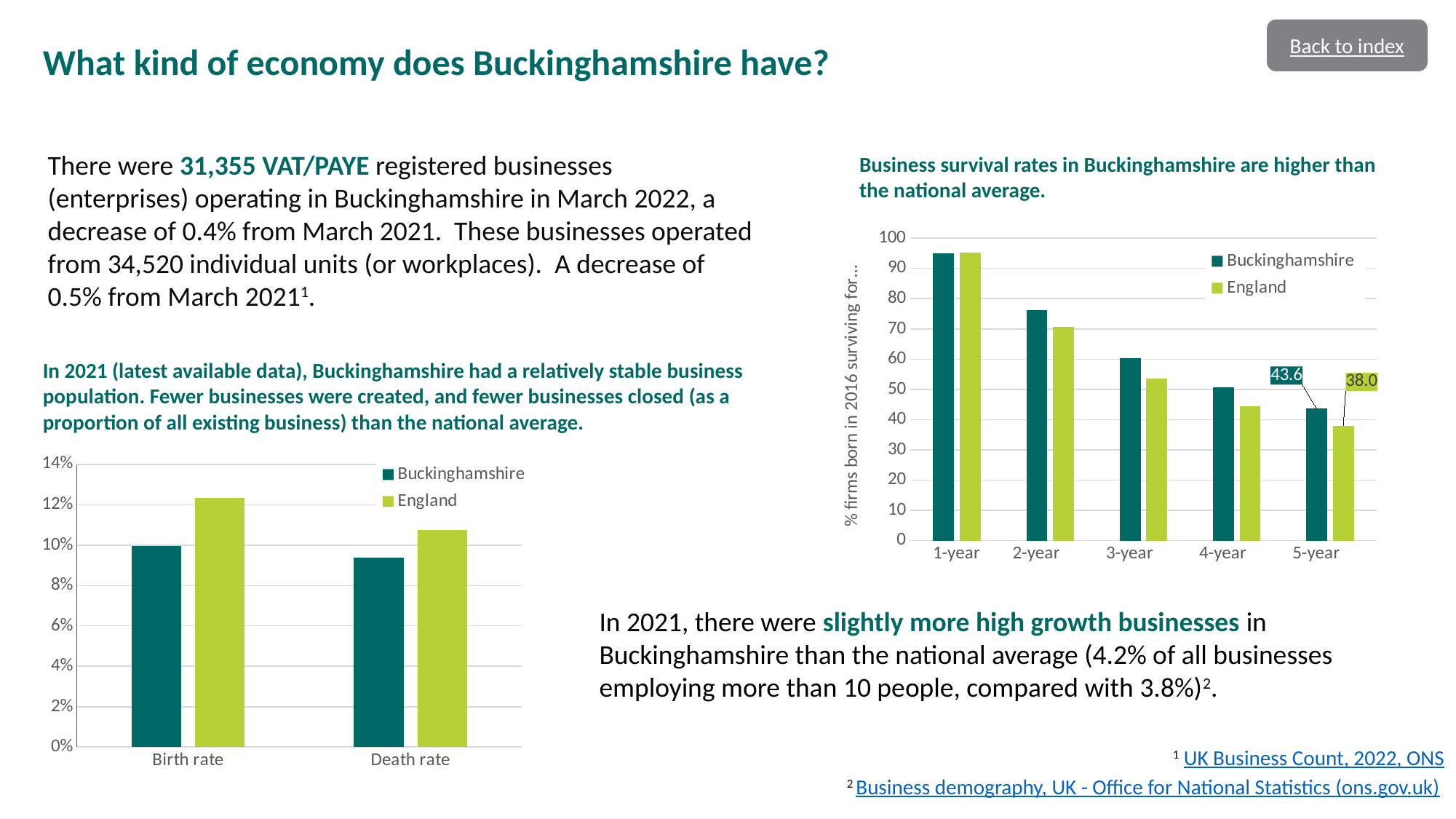
In the business survival rates chart, which series has the larger 5-year value, Buckinghamshire or England? Buckinghamshire In the business survival rates chart, how many survival periods are shown on the x axis? 5 In the business survival rates chart, what is the 5-year survival value for England? 38.0 In the birth rate and death rate chart on the left, is the England birth rate greater or less than 12%? greater In the business survival rates chart, what is the difference between the Buckinghamshire and England 5-year survival values? 5.6 In the business survival rates chart, is the 2-year value for Buckinghamshire greater or less than 70? greater What kind of chart is the birth rate and death rate chart on the left? bar chart In the business survival rates chart, is the 3-year value for England greater or less than 60? less In the business survival rates chart, what is the 5-year survival value for Buckinghamshire? 43.6 In the birth rate and death rate chart on the left, which series has the higher birth rate, Buckinghamshire or England? England In the birth rate and death rate chart on the left, how many series does the legend list? 2 In the business survival rates chart, do the Buckinghamshire values rise or fall from 1-year to 5-year? fall